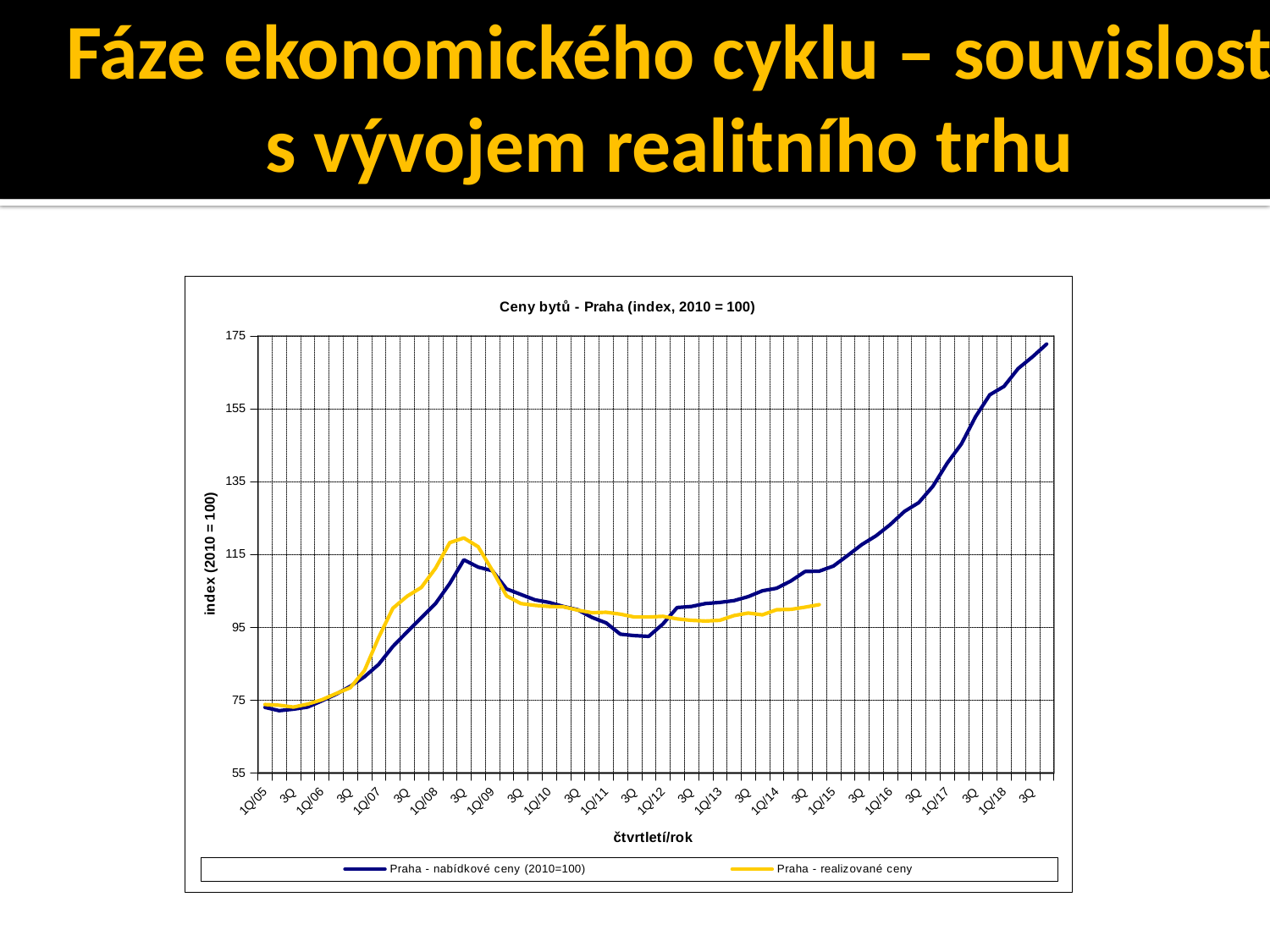
What is the title of the chart? Ceny bytů - Praha (index, 2010 = 100) Is the value of the Praha - nabídkové ceny series at 3Q/18 greater or less than 155? greater How many series does the legend list? 2 Which series is drawn in yellow? Praha - realizované ceny At 3Q/08, which series has the higher value: Praha - nabídkové ceny or Praha - realizované ceny? Praha - realizované ceny Does the Praha - nabídkové ceny series rise or fall between 1Q/13 and the end of the chart? rise Is the peak of the Praha - realizované ceny series around 3Q/08 greater or less than 115? greater What is the highest value shown on the y axis? 175 Is the value of the Praha - nabídkové ceny series at 1Q/05 greater or less than 75? less What kind of chart is shown on the slide? line chart